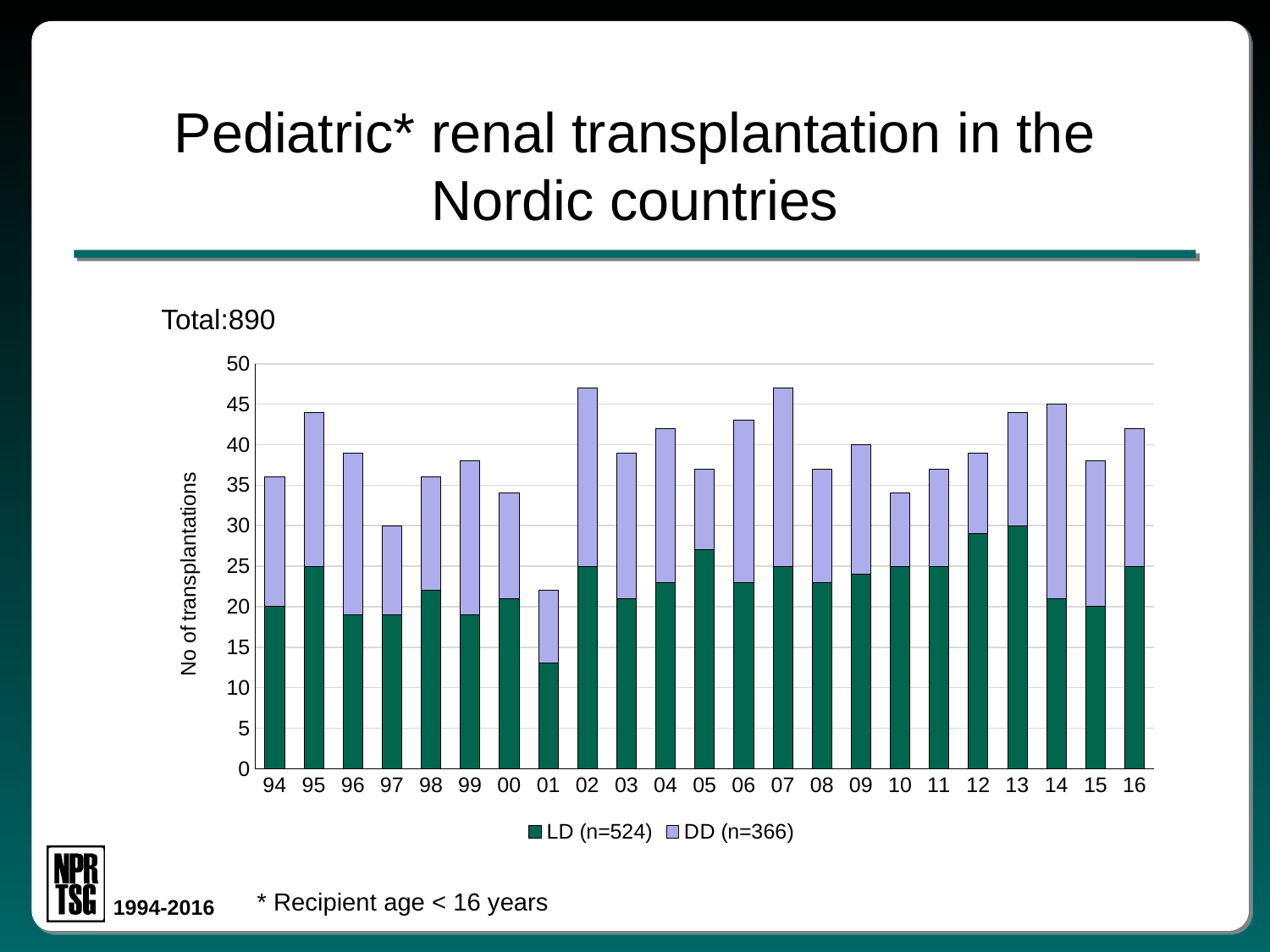
What total number of transplantations is stated above the chart? Total:890 How many years (categories) are shown on the x axis? 23 How many series does the legend list? 2 Is the total number of transplantations for 01 greater or less than 25? less Which year has the lowest LD value? 01 Which year has the larger total number of transplantations, 94 or 95? 95 Is the LD value for 13 greater or less than 25? greater What are the two legend entries of the chart? LD (n=524) and DD (n=366) What kind of chart is shown on the slide? stacked bar chart Is the total number of transplantations for 02 greater or less than 45? greater Which year has the lowest total number of transplantations? 01